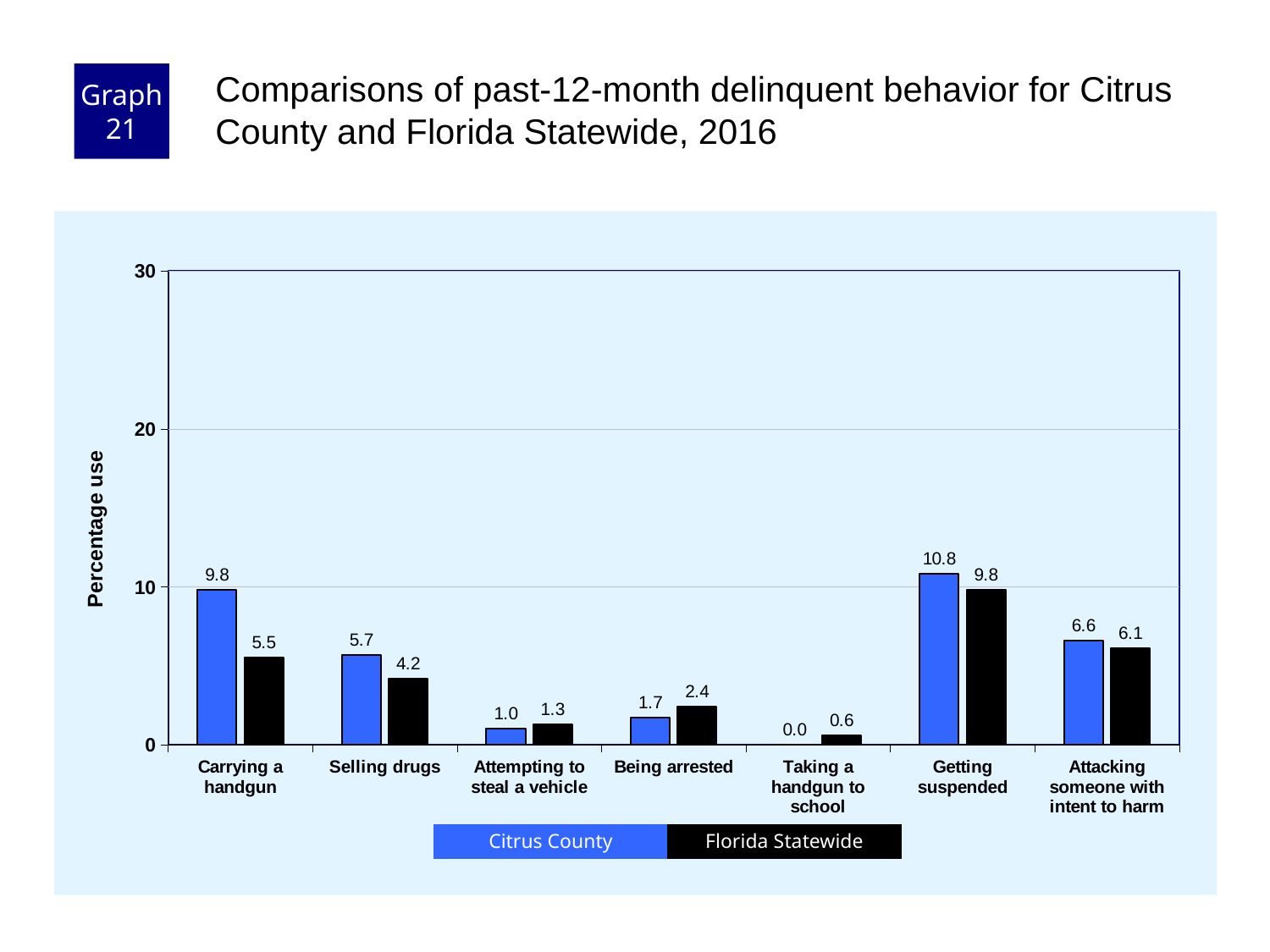
Is the Citrus County value for Getting suspended greater or less than 10? greater How many series does the legend list? 2 How many categories are shown on the x axis? 7 What is the difference between the Citrus County and Florida Statewide values for Carrying a handgun? 4.3 For Being arrested, which is larger: the Citrus County value or the Florida Statewide value? Florida Statewide What is the Citrus County value for Carrying a handgun? 9.8 What is the Citrus County value for Taking a handgun to school? 0.0 What kind of chart is shown on the slide? bar chart What is the Florida Statewide value for Selling drugs? 4.2 Which category has the lowest Florida Statewide value? Taking a handgun to school Which category has the highest Citrus County value? Getting suspended What is the difference between the Citrus County and Florida Statewide values for Getting suspended? 1.0